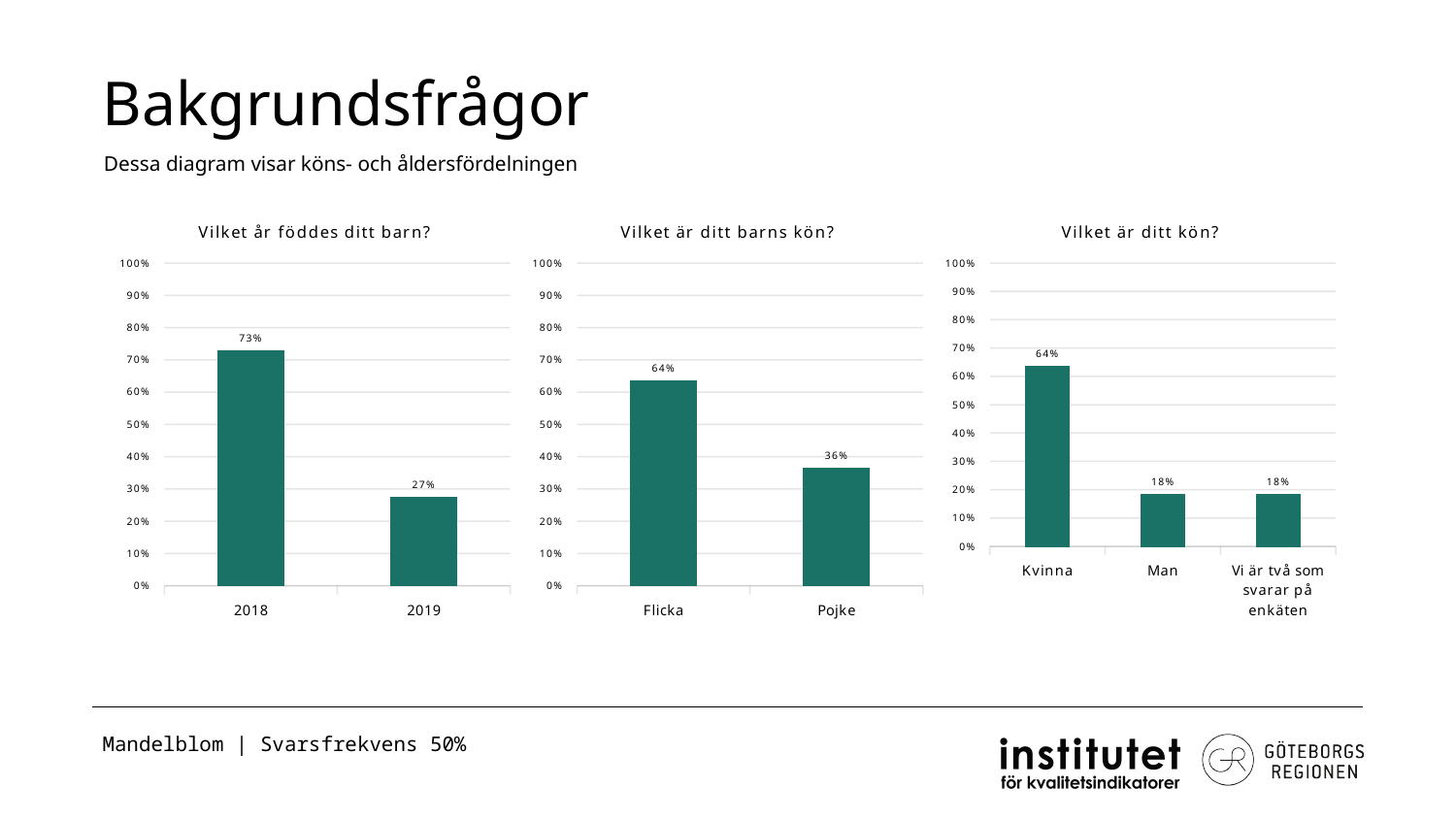
In the chart 'Vilket är ditt kön?', which category has the highest value? Kvinna What kind of chart is 'Vilket är ditt barns kön?'? Bar chart In the chart 'Vilket är ditt barns kön?', what is the difference between Flicka and Pojke? 28% In the chart 'Vilket är ditt barns kön?', which category has the lowest value? Pojke In the chart 'Vilket är ditt barns kön?', what is the value for Flicka? 64% In the chart 'Vilket år föddes ditt barn?', what is the value for 2019? 27% In the chart 'Vilket år föddes ditt barn?', is the value for 2019 greater or less than 30%? less In the chart 'Vilket är ditt kön?', what is the value for Man? 18% In the chart 'Vilket är ditt kön?', what is the value for Kvinna? 64% In the chart 'Vilket år föddes ditt barn?', what is the value for 2018? 73% In the chart 'Vilket är ditt kön?', how many categories are shown on the x axis? 3 In the chart 'Vilket år föddes ditt barn?', what is the difference between the values for 2018 and 2019? 46%